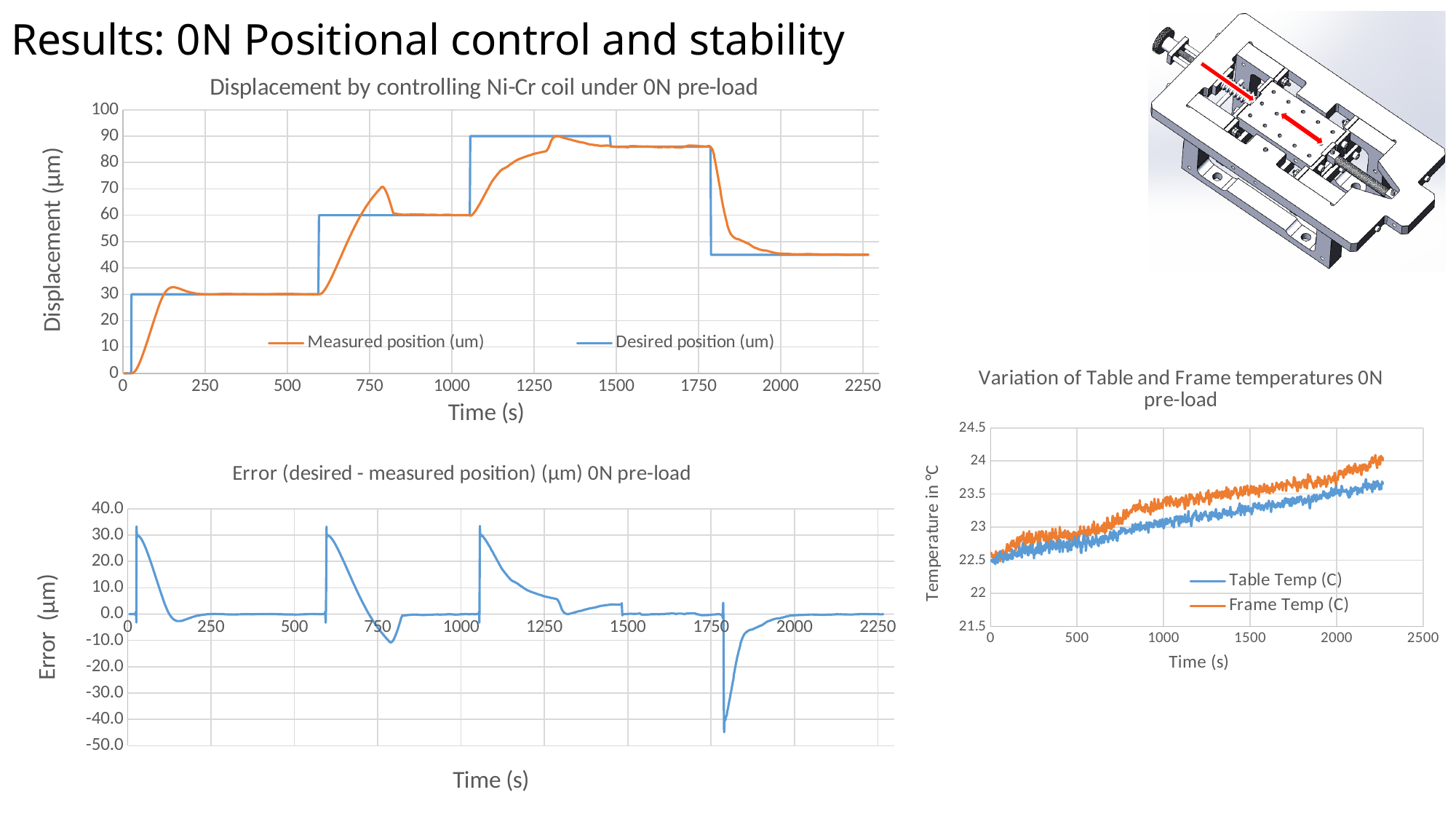
In the 'Displacement by controlling Ni-Cr coil under 0N pre-load' chart, how many series does the legend list? 2 In the 'Displacement by controlling Ni-Cr coil under 0N pre-load' chart, is the measured position at time 800 s greater or less than 60? greater In the 'Variation of Table and Frame temperatures 0N pre-load' chart, which series is higher at time 1500 s, Table Temp (C) or Frame Temp (C)? Frame Temp (C) In the 'Error (desired - measured position) (µm) 0N pre-load' chart, is the peak error just after 1000 s greater or less than 20.0? greater In the 'Displacement by controlling Ni-Cr coil under 0N pre-load' chart, what type of chart is shown? line chart In the 'Variation of Table and Frame temperatures 0N pre-load' chart, what is the label of the y axis? Temperature in °C In the 'Displacement by controlling Ni-Cr coil under 0N pre-load' chart, what is the desired position at time 1250 s? 90 In the 'Variation of Table and Frame temperatures 0N pre-load' chart, do the temperatures rise or fall over time? rise In the 'Displacement by controlling Ni-Cr coil under 0N pre-load' chart, which series is drawn in orange? Measured position (um) In the 'Variation of Table and Frame temperatures 0N pre-load' chart, how many series does the legend list? 2